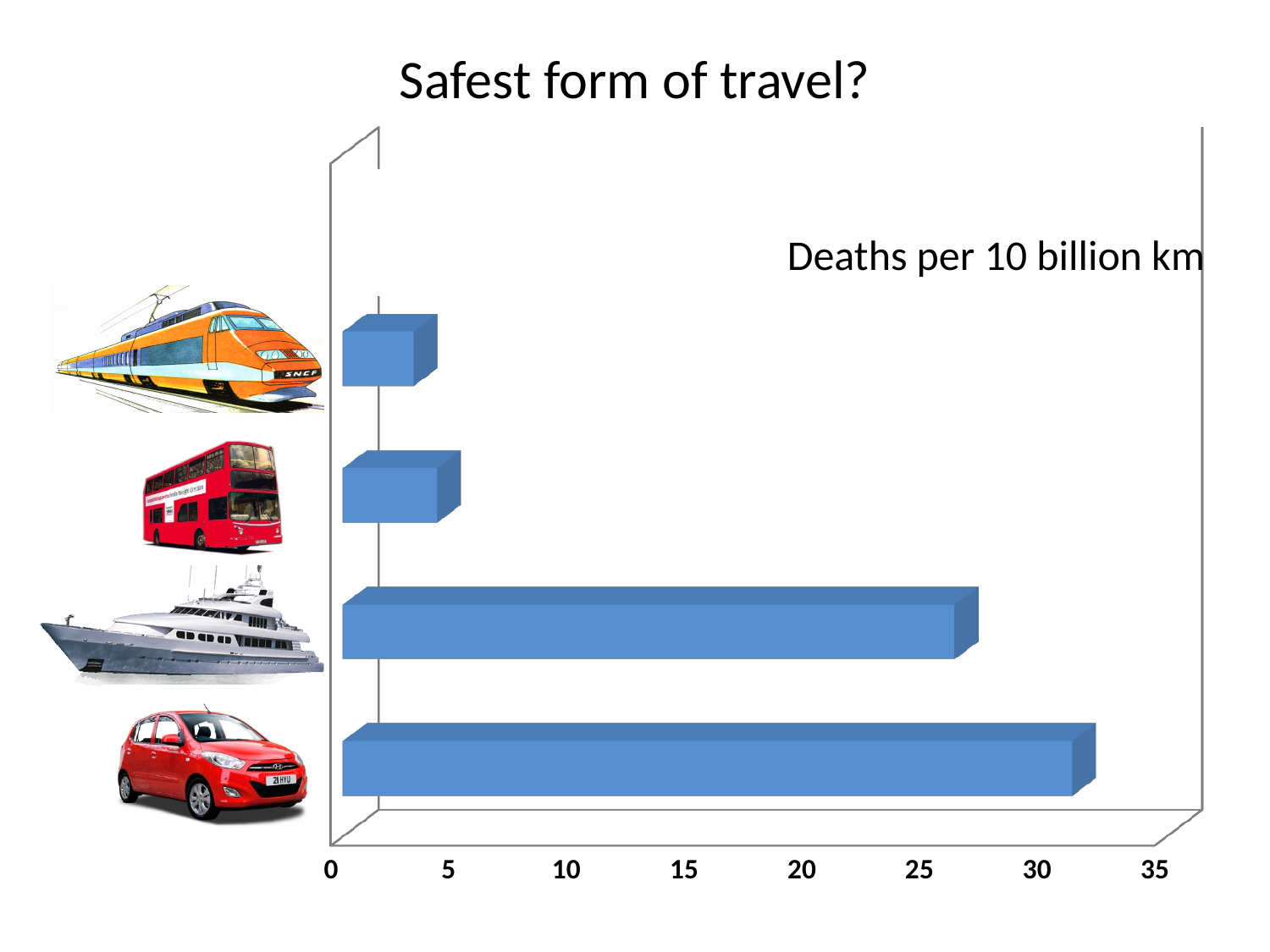
How many bars are plotted in the chart? 4 Is the value of the third bar from the top greater or less than 25? greater What is the title of the slide's chart? Safest form of travel? Which bar is the longest in the chart? the bottom bar What quantity does the chart say it measures, according to the text inside the plot area? Deaths per 10 billion km Is the value of the bottom bar greater or less than 35? less Which bar is the shortest in the chart? the top bar Is the value of the second bar from the top greater or less than 10? less What kind of chart is shown on the slide? bar chart Which is larger, the value of the third bar from the top or the value of the second bar from the top? the third bar from the top